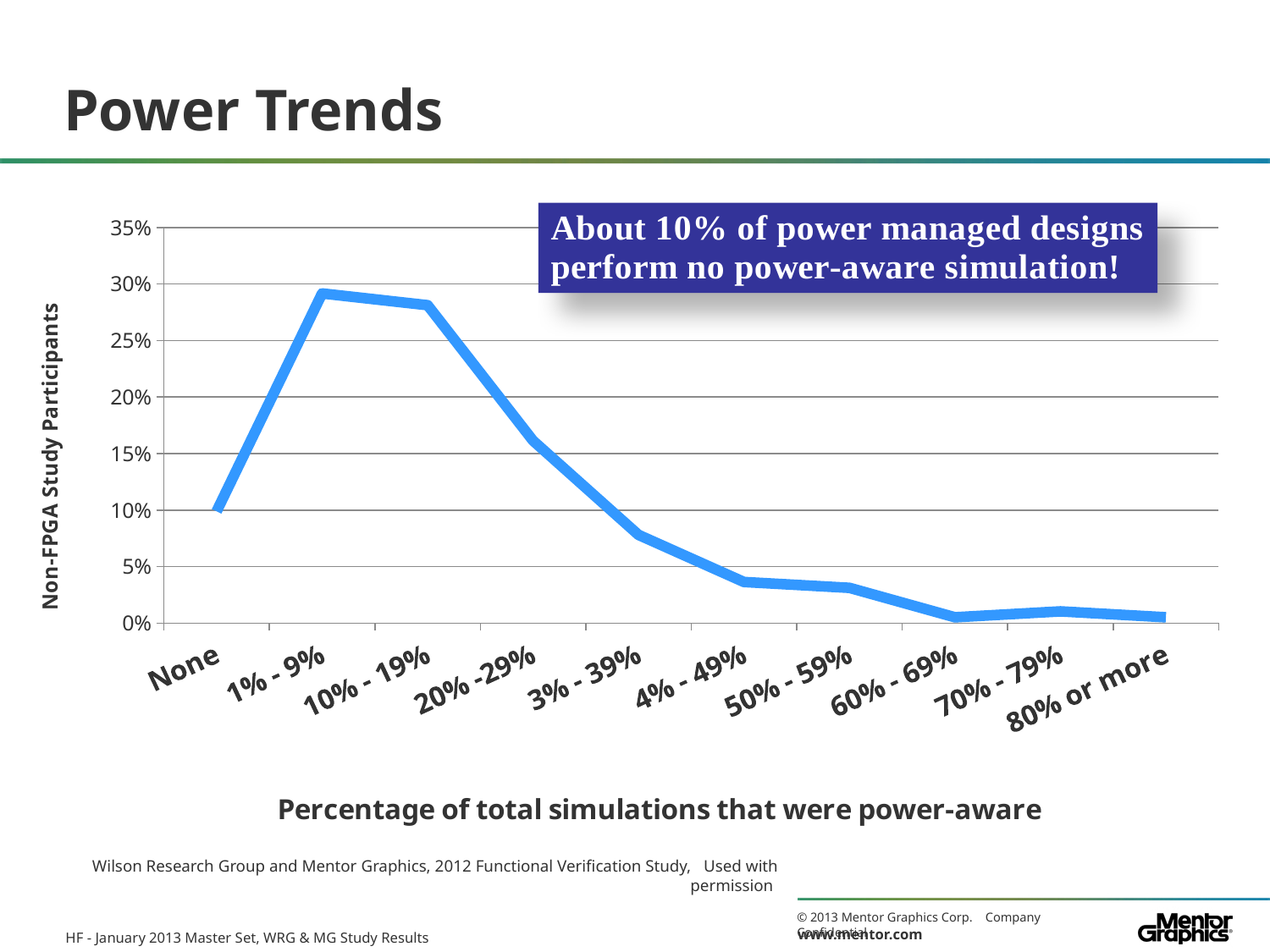
Is the value for 10% - 19% greater or less than 25%? greater How many categories are shown along the x axis of the chart? 10 What is the title of the vertical axis of the chart? Non-FPGA Study Participants Is the value for None greater or less than 5%? greater Which category has the highest value in the chart? 1% - 9% What kind of chart is shown on the slide? line chart Is the value for 1% - 9% greater or less than 25%? greater Do the values rise or fall along the x axis from 1% - 9% to 80% or more? fall